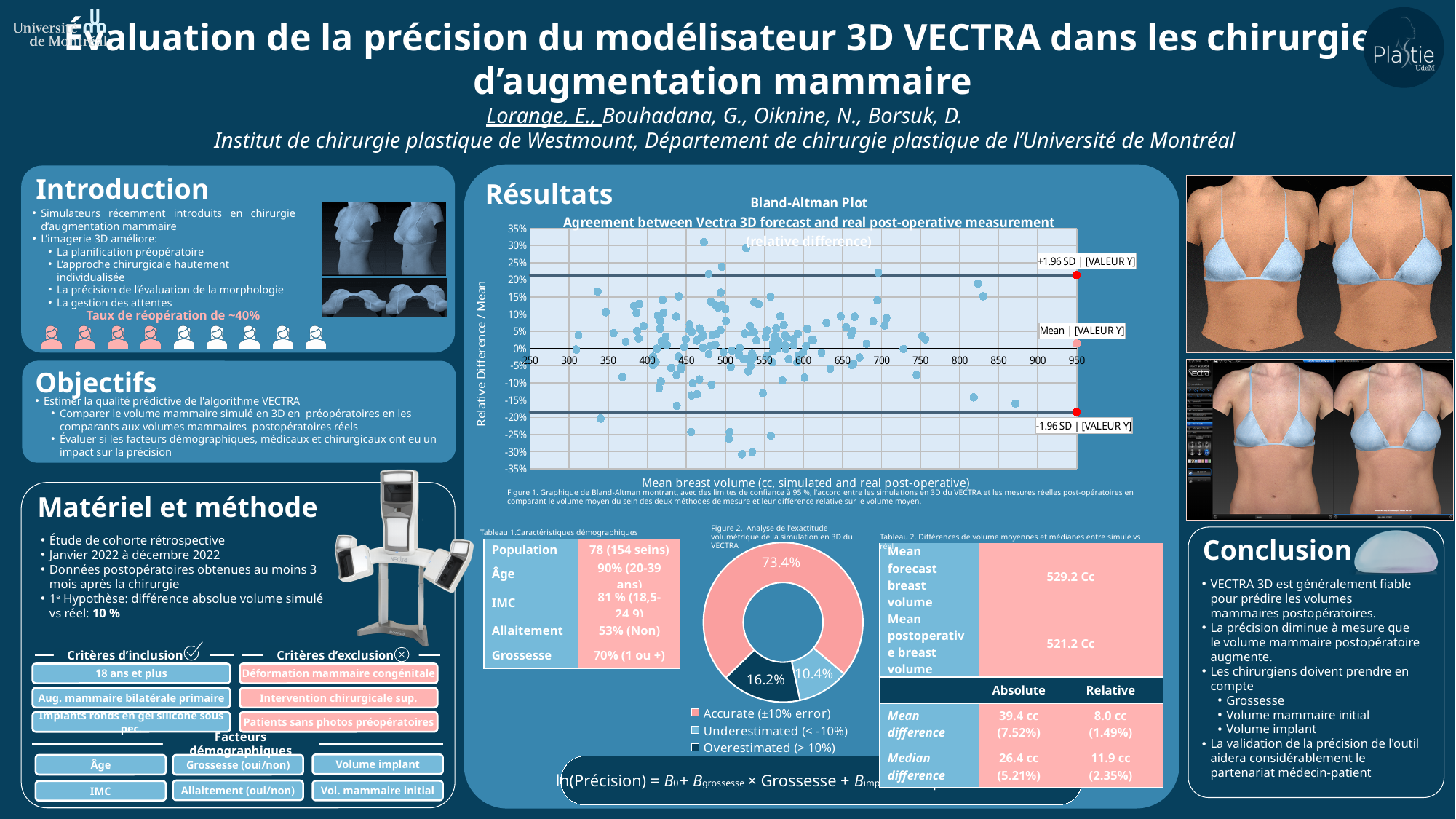
What is the y-axis label of the Bland-Altman Plot? Relative Difference / Mean In Figure 2, what percentage of simulations were Accurate (±10% error)? 73.4% In the Bland-Altman Plot, is the +1.96 SD limit line greater or less than 15%? greater What kind of chart is the Bland-Altman Plot? scatter plot What kind of chart is Figure 2 (the chart showing Accurate, Underestimated and Overestimated)? doughnut chart In Figure 2, which category has the largest share? Accurate (±10% error) In Figure 2, what is the difference between the Overestimated and Underestimated shares? 5.8% How many categories does the legend of Figure 2 list? 3 In Figure 2, which is larger: the Overestimated share or the Underestimated share? Overestimated In Figure 2, what percentage of simulations were Underestimated (< -10%)? 10.4% In Figure 2, which category has the smallest share? Underestimated (< -10%) In Figure 2, what percentage of simulations were Overestimated (> 10%)? 16.2%